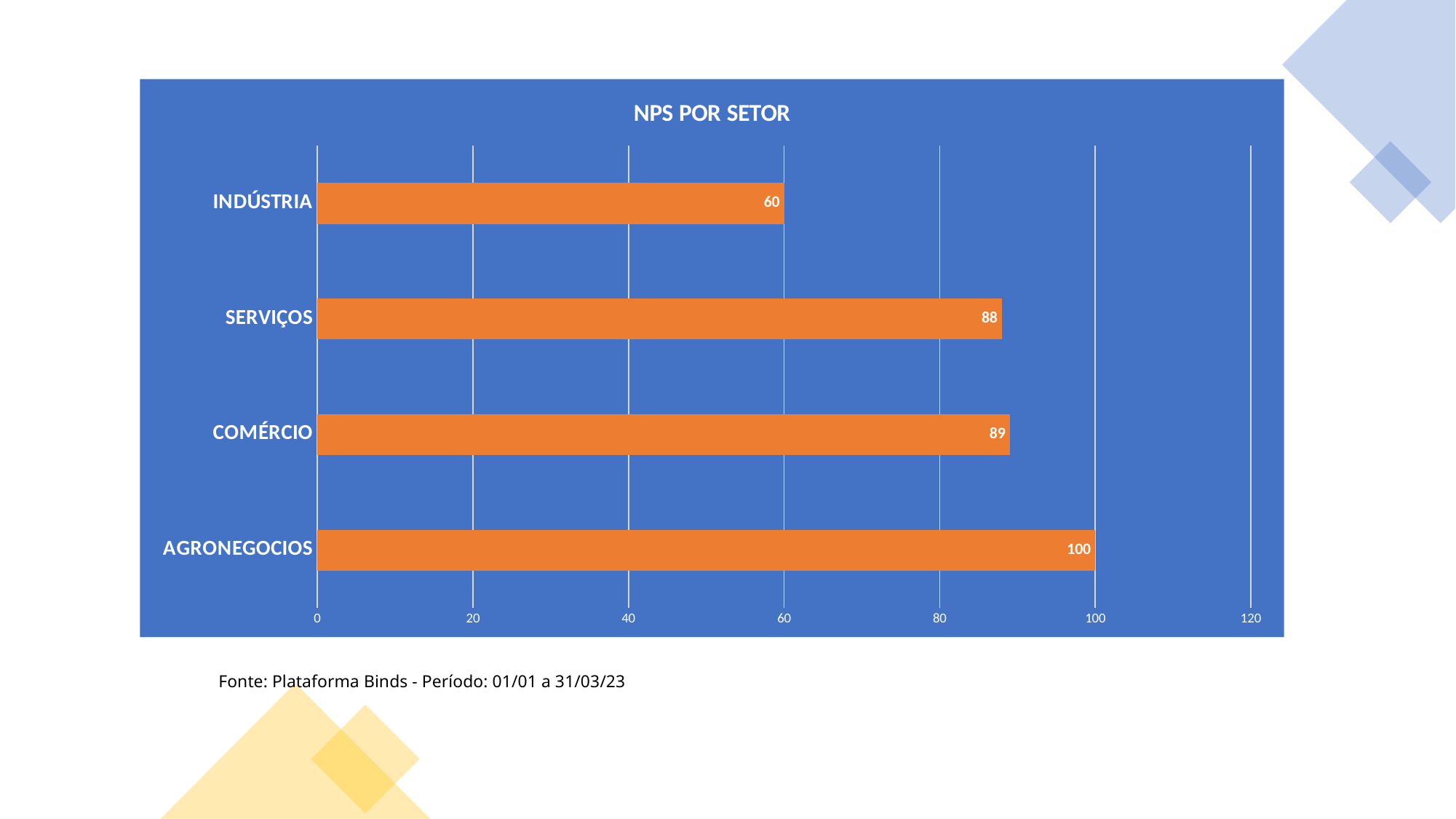
What is the NPS value for SERVIÇOS? 88 What is the difference between the NPS of COMÉRCIO and SERVIÇOS? 1 Which has a higher NPS, SERVIÇOS or INDÚSTRIA? SERVIÇOS Which sector has the highest NPS? AGRONEGOCIOS Which sector has the lowest NPS? INDÚSTRIA What is the title of the chart? NPS POR SETOR What is the difference between the NPS of AGRONEGOCIOS and INDÚSTRIA? 40 How many sectors are shown in the chart? 4 What is the NPS value for INDÚSTRIA? 60 What kind of chart is shown on the slide? Bar chart What is the NPS value for COMÉRCIO? 89 What is the NPS value for AGRONEGOCIOS? 100